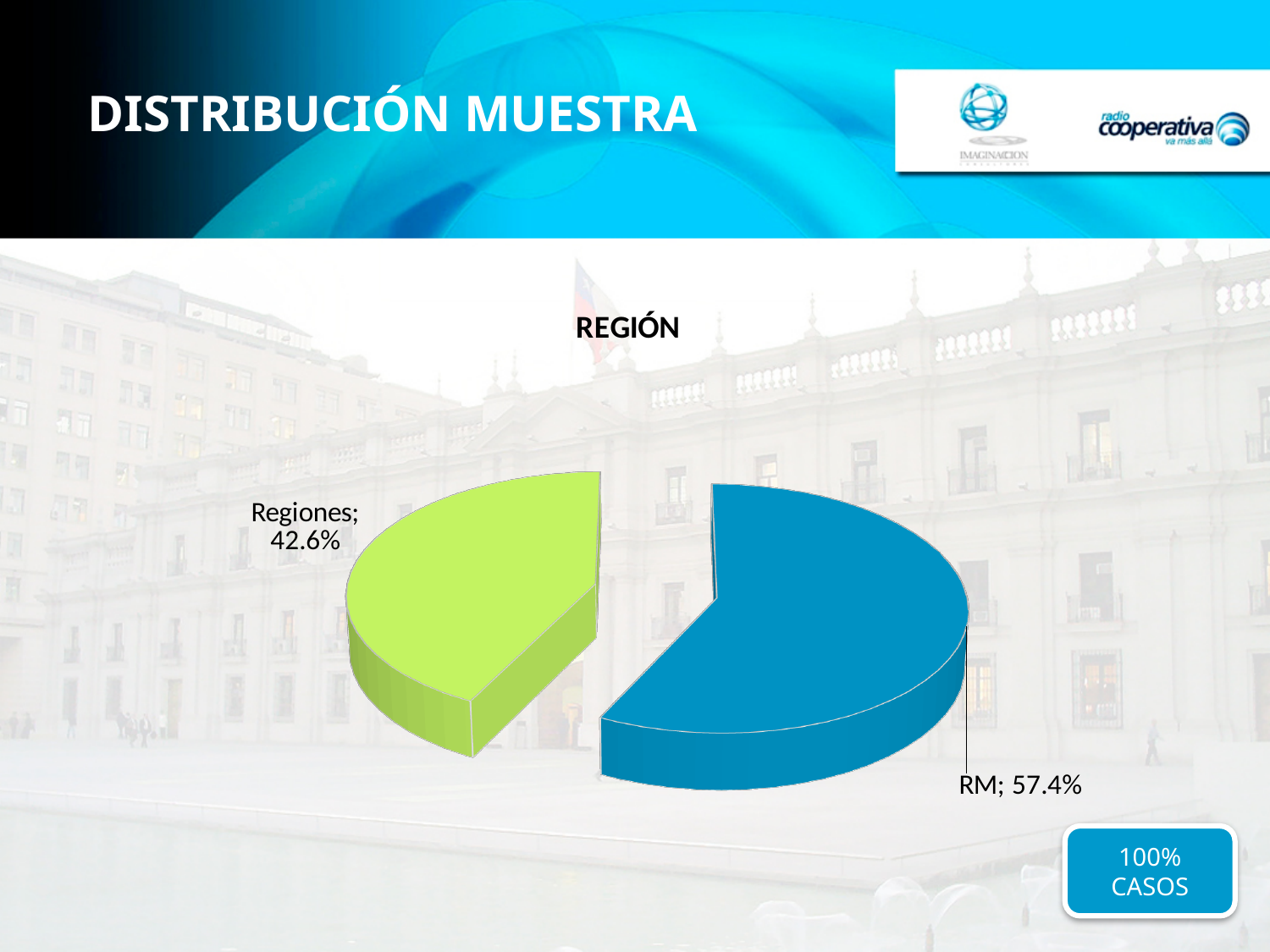
Which slice of the REGIÓN pie chart is the largest? RM Which slice of the REGIÓN pie chart is the smallest? Regiones What is the title of the chart on the slide? REGIÓN What is the value for Regiones in the REGIÓN pie chart? 42.6% What colour is the RM slice in the REGIÓN pie chart? Blue What share of the REGIÓN pie does the Regiones slice represent? 42.6% What is the value for RM in the REGIÓN pie chart? 57.4% How many slices does the REGIÓN pie chart have? 2 What kind of chart is shown on the slide? Pie chart What is the difference between the RM and Regiones shares in the REGIÓN pie chart? 14.8% Which is larger in the REGIÓN pie chart, RM or Regiones? RM